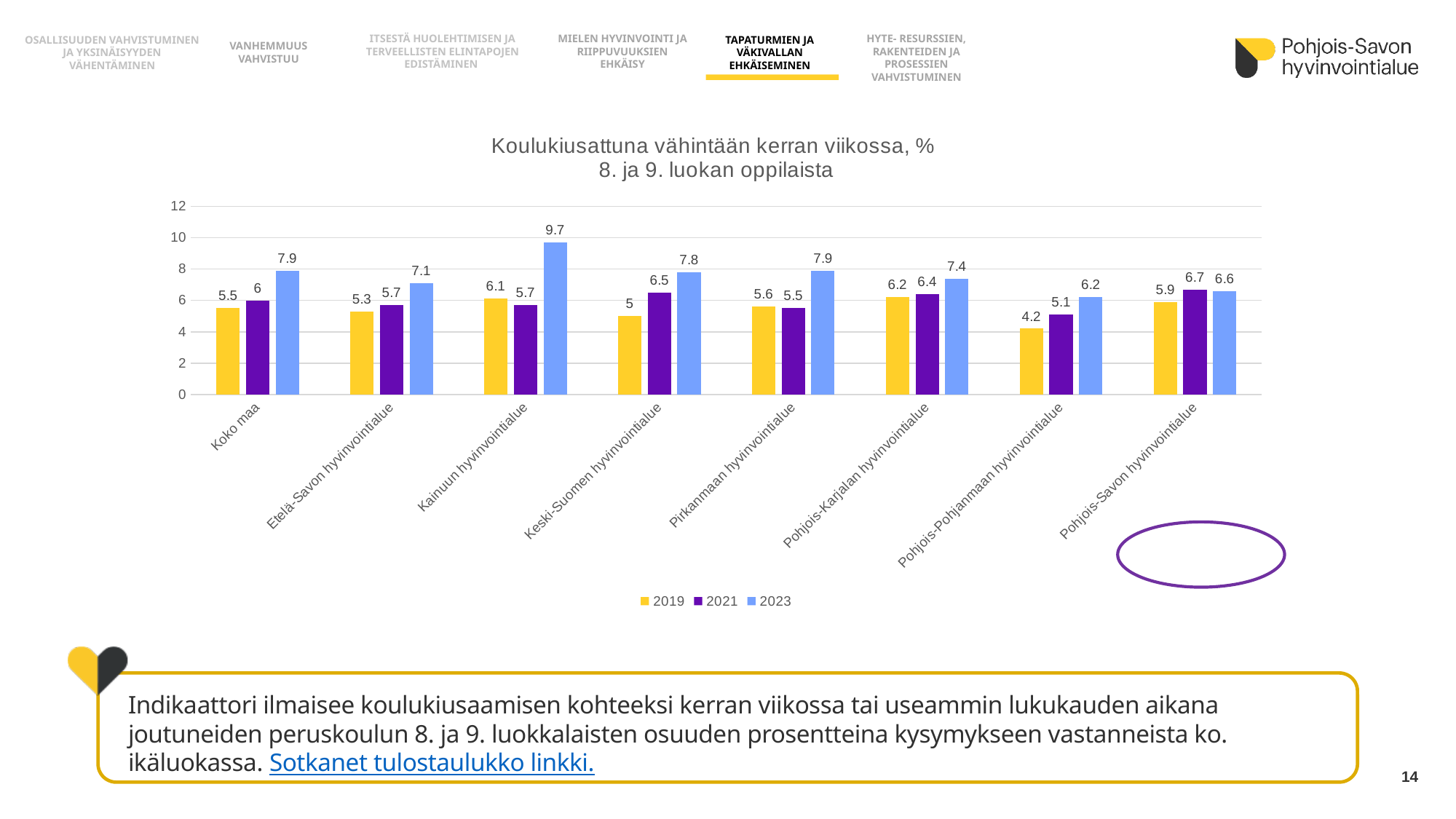
What is the 2021 value for Koko maa? 6 What is the difference between the 2023 and 2019 values for Keski-Suomen hyvinvointialue? 2.8 Which colour represents the 2019 series in the legend? Yellow For Pirkanmaan hyvinvointialue, do the values rise or fall from 2021 to 2023? Rise How many regions (categories) are shown on the x axis? 8 Which is larger for Pohjois-Savon hyvinvointialue, the 2021 value or the 2023 value? 2021 Which region has the lowest 2019 value? Pohjois-Pohjanmaan hyvinvointialue What is the 2019 value for Pohjois-Savon hyvinvointialue? 5.9 What kind of chart is shown on the slide? Bar chart Which region has the highest 2023 value? Kainuun hyvinvointialue How many series does the legend list? 3 What is the 2023 value for Kainuun hyvinvointialue? 9.7